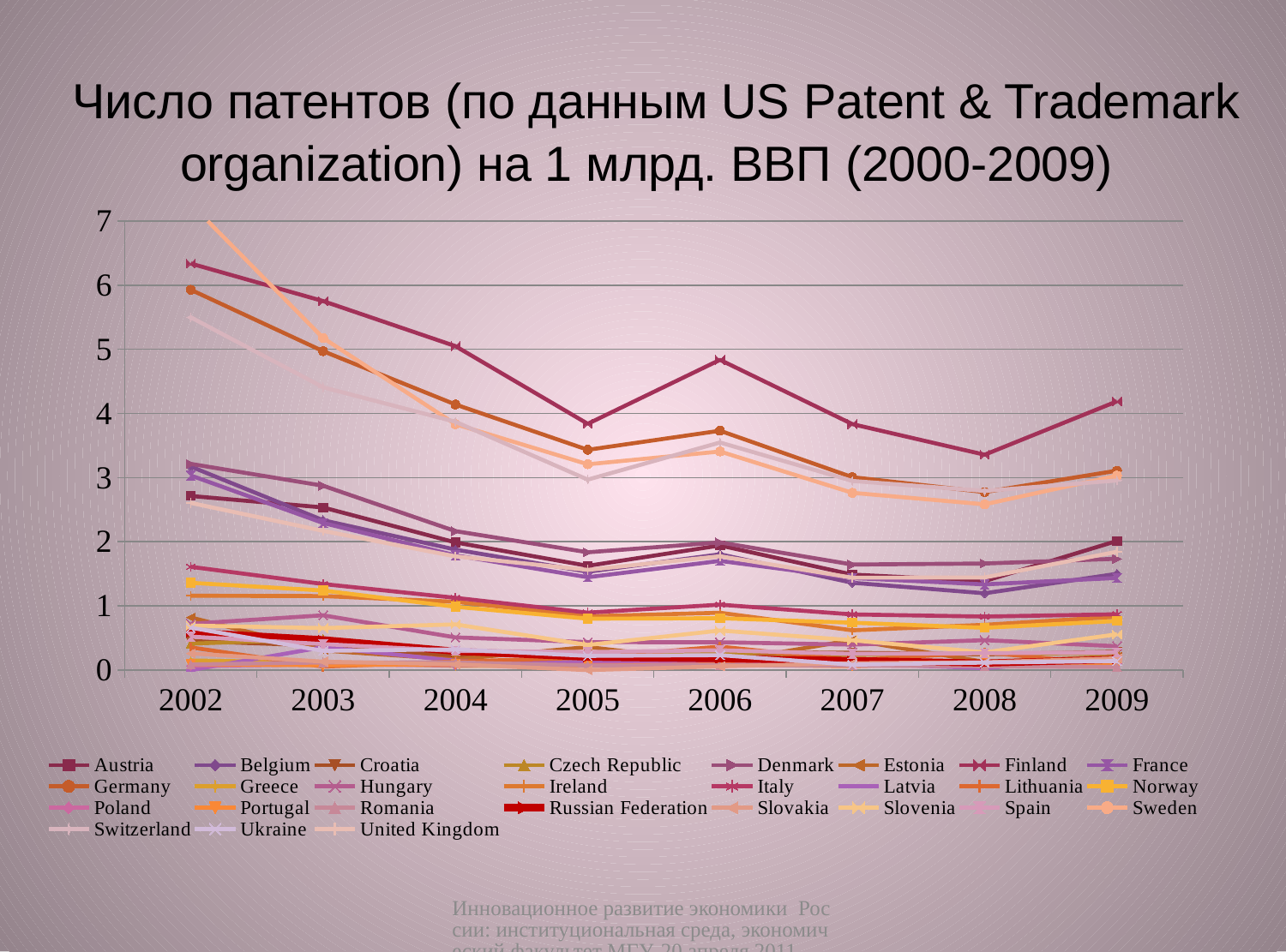
Is the value for Finland in 2002 greater or less than 6? greater Is the value for Finland in 2009 greater or less than 4? greater Which is larger in 2009, the value for Finland or the value for Germany? Finland Is the value for Finland in 2005 greater or less than 4? less Which country has the highest value in 2009? Finland How many countries does the legend list? 27 What kind of chart is shown on the slide? line chart In which year does Finland reach its highest value? 2002 What is the first year shown on the x axis? 2002 How many years are plotted along the x axis? 8 Does the value for Finland rise or fall from 2002 to 2005? fall